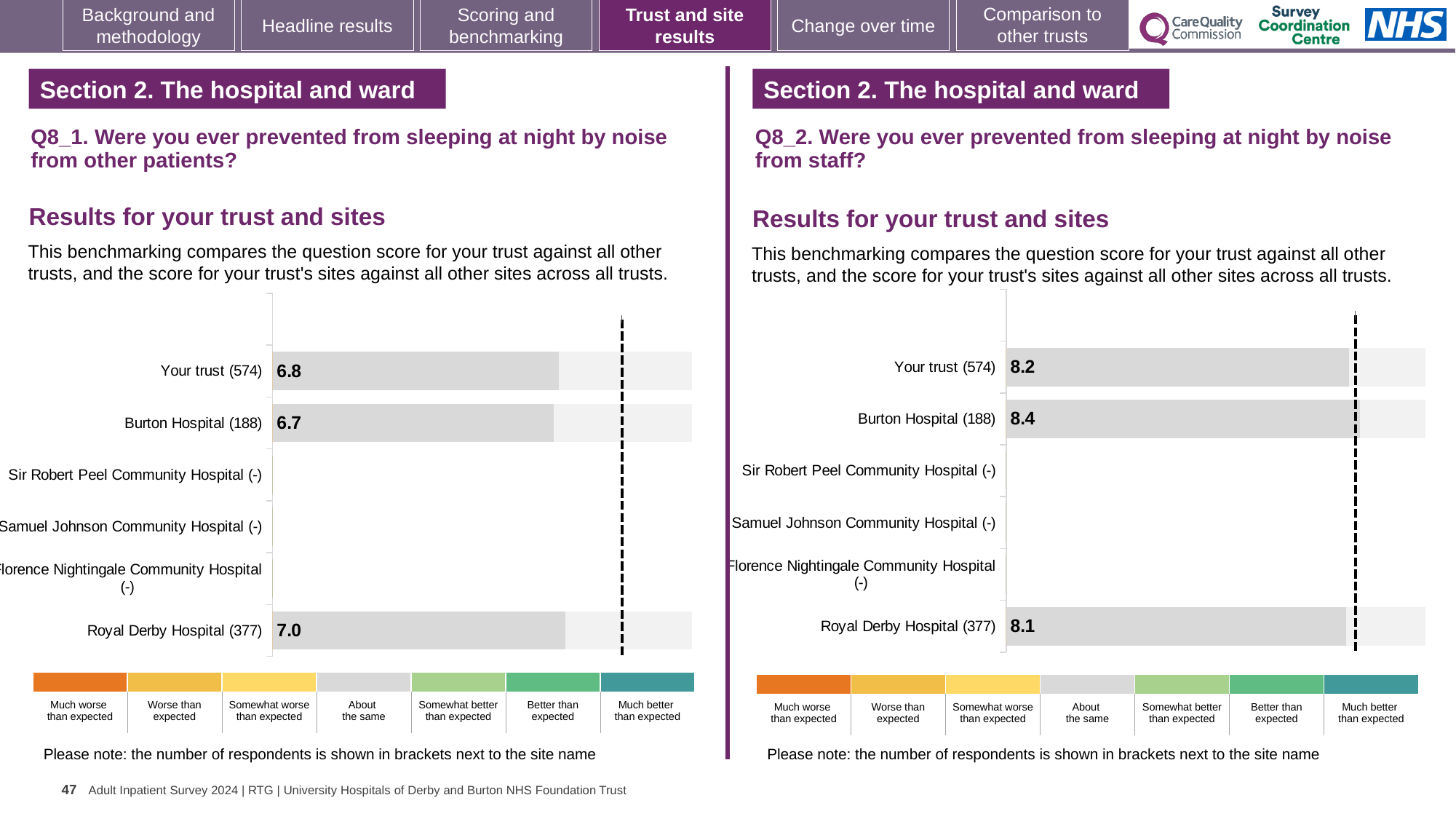
On the Q8_1 chart (noise from other patients), what is the score for Royal Derby Hospital (377)? 7.0 On the Q8_1 chart (noise from other patients), which has the larger score: Your trust (574) or Burton Hospital (188)? Your trust (574) On the Q8_1 chart (noise from other patients), which site or trust has the lowest score? Burton Hospital (188) On the Q8_1 chart (noise from other patients), which site or trust has the highest score? Royal Derby Hospital (377) On the Q8_2 chart (noise from staff), which site or trust has the highest score? Burton Hospital (188) What kind of chart is used on the Q8_2 chart (noise from staff)? Bar chart On the Q8_1 chart (noise from other patients), what is the score for Your trust (574)? 6.8 On the Q8_2 chart (noise from staff), what is the score for Burton Hospital (188)? 8.4 On the Q8_2 chart (noise from staff), what is the difference between the scores for Burton Hospital (188) and Royal Derby Hospital (377)? 0.3 On the Q8_2 chart (noise from staff), which has the larger score: Your trust (574) or Royal Derby Hospital (377)? Your trust (574) On the Q8_2 chart (noise from staff), what is the score for Royal Derby Hospital (377)? 8.1 How many sites or trusts are listed on the Q8_1 chart (noise from other patients)? 6